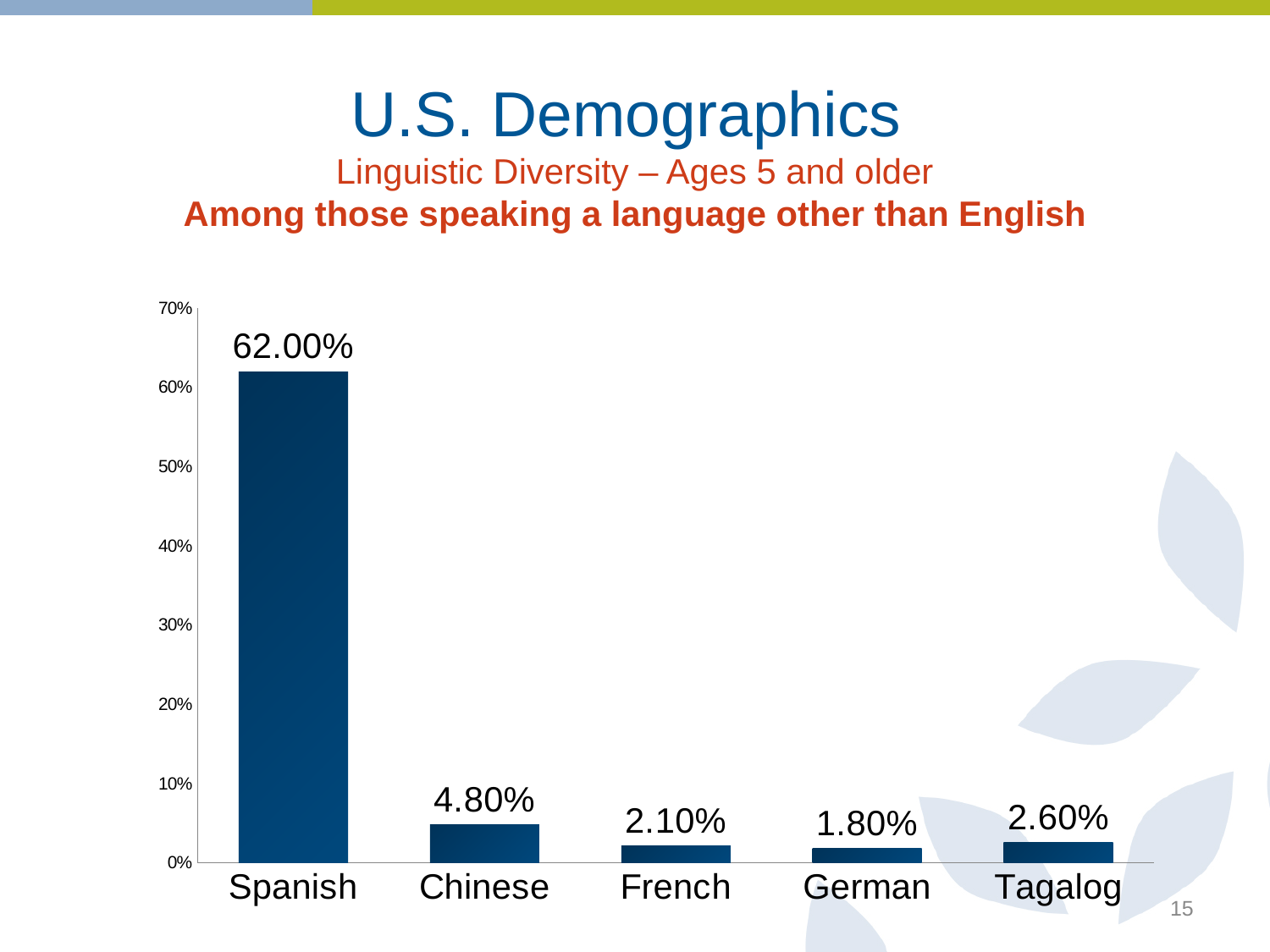
What is the difference between the values for Spanish and Chinese? 57.20% What is the value for Spanish? 62.00% Which language has the highest value? Spanish Which is larger, the value for French or the value for Tagalog? Tagalog How many languages are shown on the chart? 5 What is the value for Tagalog? 2.60% What is the difference between the values for Tagalog and German? 0.80% What is the value for Chinese? 4.80% What kind of chart is shown on the slide? Bar chart Which language has the lowest value? German Is the value for Spanish greater or less than 60%? greater What is the maximum value shown on the vertical axis? 70%